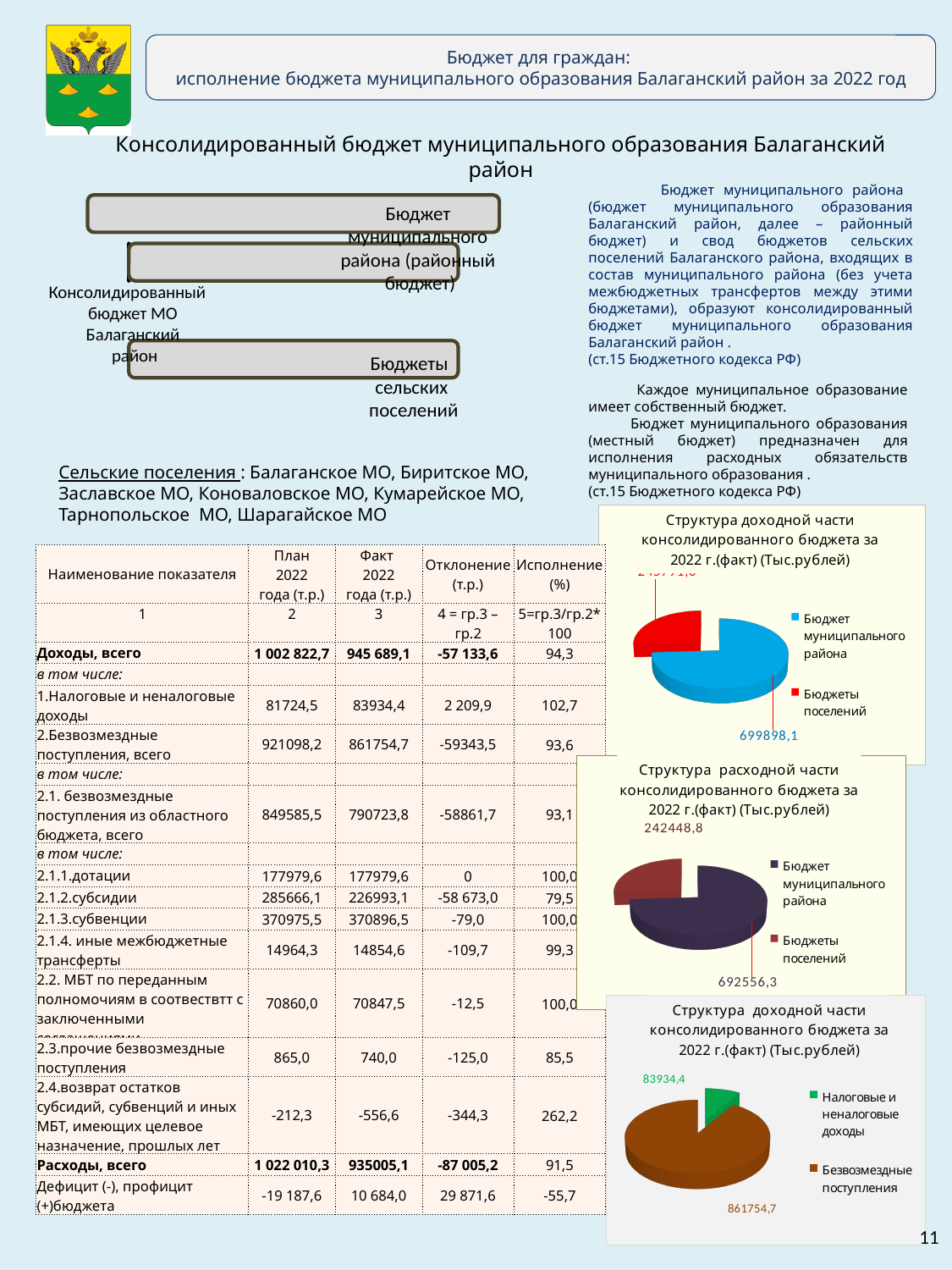
In the bottom-right pie chart, what is the difference between Безвозмездные поступления and Налоговые и неналоговые доходы? 777820,3 In the bottom-right pie chart, what is the value for Налоговые и неналоговые доходы? 83934,4 In the bottom-right pie chart, which slice is larger: Налоговые и неналоговые доходы or Безвозмездные поступления? Безвозмездные поступления In the middle-right pie chart 'Структура расходной части консолидированного бюджета за 2022 г.(факт)', what is the difference between Бюджет муниципального района and Бюджеты поселений? 450107,5 In the middle-right pie chart 'Структура расходной части консолидированного бюджета за 2022 г.(факт)', which slice is the largest? Бюджет муниципального района In the top-right pie chart showing the structure of the revenue part of the consolidated budget by Бюджет муниципального района and Бюджеты поселений, what is the value for Бюджет муниципального района? 699898,1 In the middle-right pie chart 'Структура расходной части консолидированного бюджета за 2022 г.(факт)', what is the value for Бюджет муниципального района? 692556,3 In the top-right pie chart showing the structure of the revenue part of the consolidated budget by Бюджет муниципального района and Бюджеты поселений, which slice is the smallest? Бюджеты поселений How many entries does the legend of the bottom-right pie chart list? 2 What kind of chart is the bottom-right chart titled 'Структура доходной части консолидированного бюджета за 2022 г.(факт)' with slices for Налоговые и неналоговые доходы and Безвозмездные поступления? pie chart In the middle-right pie chart 'Структура расходной части консолидированного бюджета за 2022 г.(факт)', what is the value for Бюджеты поселений? 242448,8 In the bottom-right pie chart, what is the value for Безвозмездные поступления? 861754,7